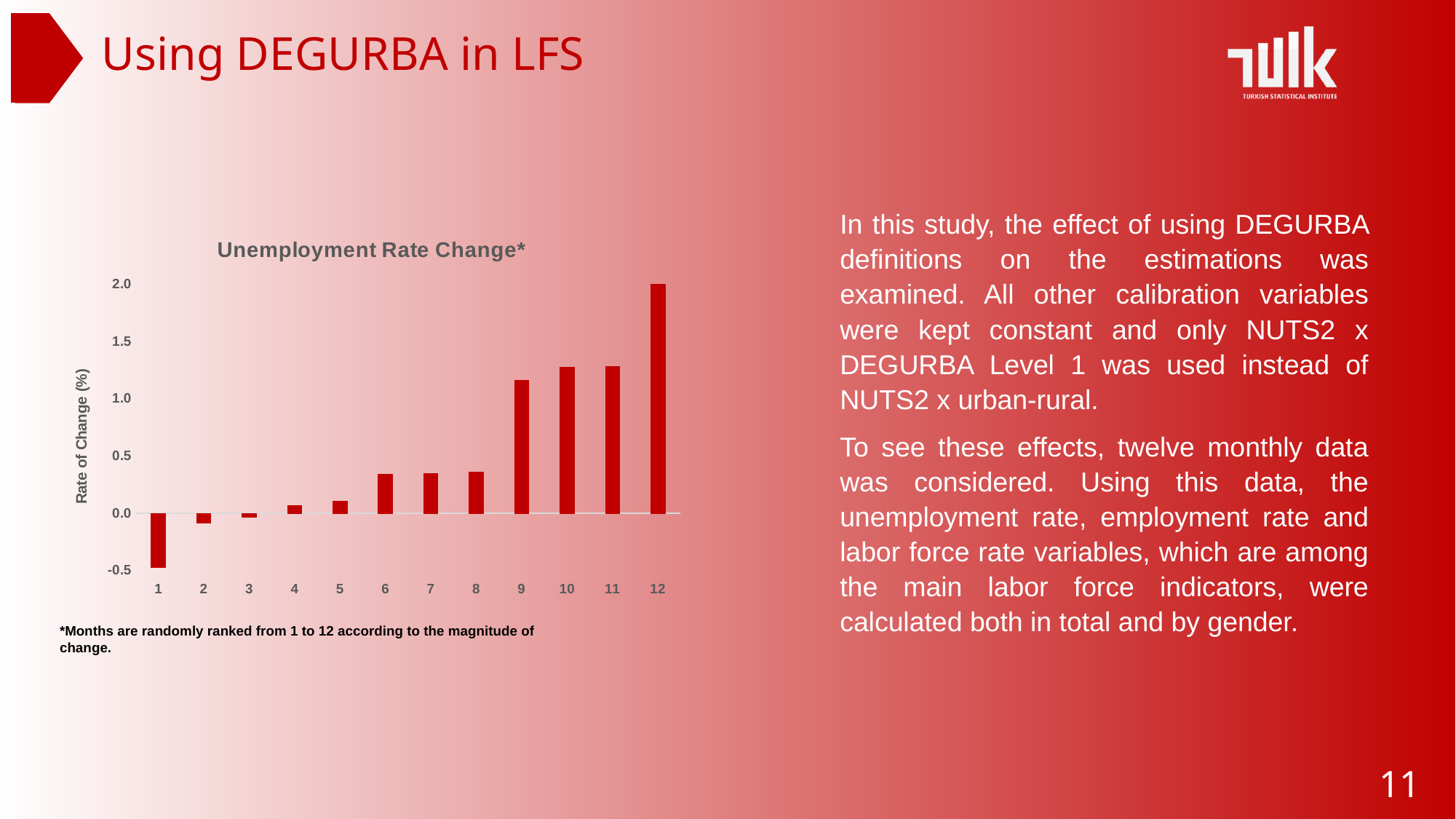
Is the value for month 1 greater or less than 0.0? less How many categories (months) are plotted on the x axis? 12 Is the value for month 9 greater or less than 1.0? greater What kind of chart is shown on the slide? bar chart Is the value for month 6 greater or less than 0.5? less What is the label on the vertical axis of the chart? Rate of Change (%) Do the values rise or fall as you move from month 1 to month 12 along the x axis? rise Which month has the highest unemployment rate change? 12 Which has the larger value, month 2 or month 4? 4 Which month has the lowest unemployment rate change? 1 What is the title of the chart? Unemployment Rate Change*